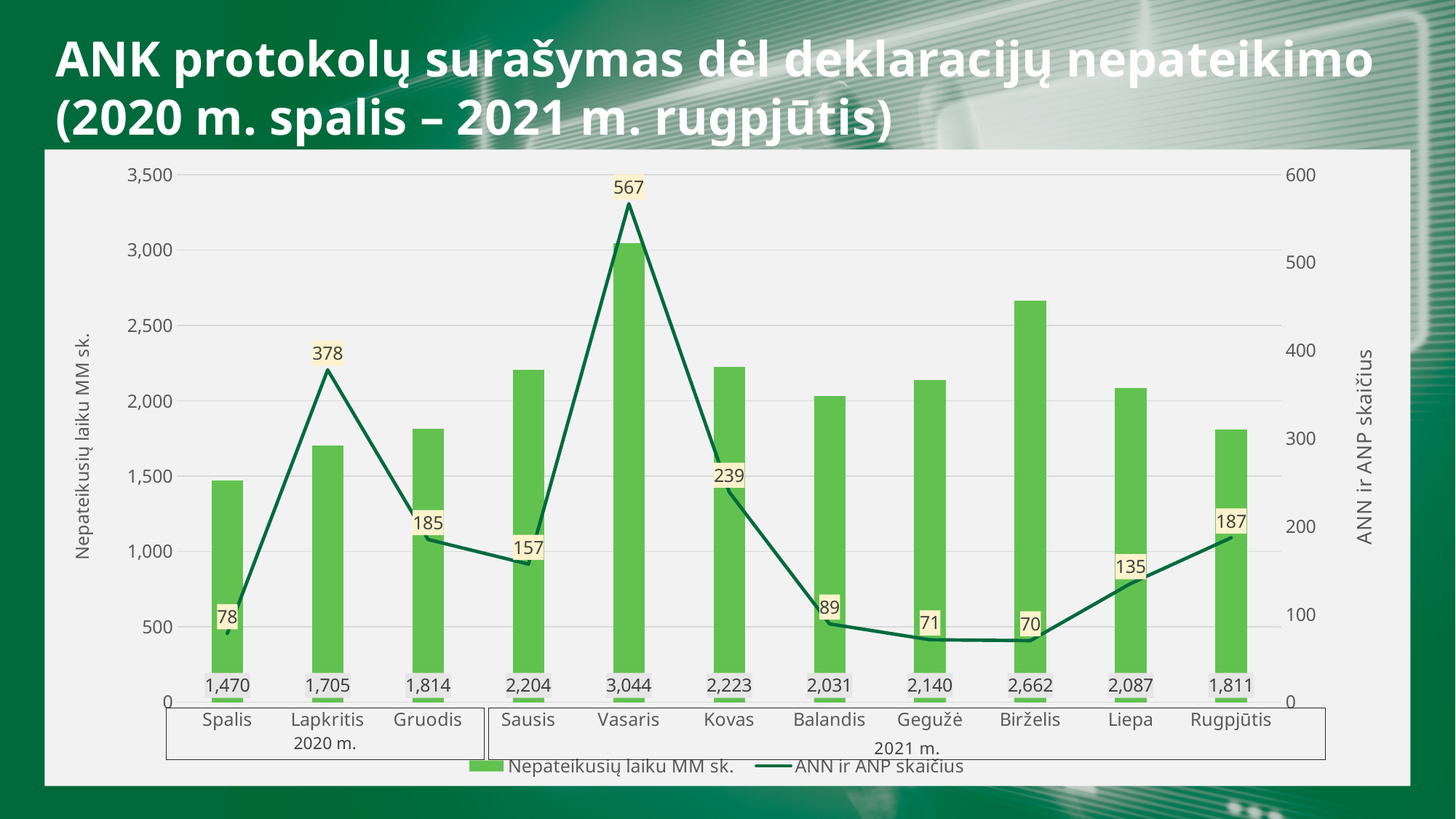
What kind of chart is shown on the slide? Combination bar and line chart How many months are shown on the x axis? 11 How many series does the legend list? 2 What is the value of 'Nepateikusių laiku MM sk.' for Vasaris? 3,044 What is the difference in 'ANN ir ANP skaičius' between Vasaris and Kovas? 328 What is the value of 'ANN ir ANP skaičius' for Lapkritis? 378 Which month has the lowest 'Nepateikusių laiku MM sk.' value? Spalis Which is larger, the 'Nepateikusių laiku MM sk.' value for Kovas or for Gegužė? Kovas What is the label of the right-hand vertical axis? ANN ir ANP skaičius Which month has the highest 'ANN ir ANP skaičius' value? Vasaris Which month has the lowest 'ANN ir ANP skaičius' value? Birželis What is the difference in 'Nepateikusių laiku MM sk.' between Birželis and Liepa? 575